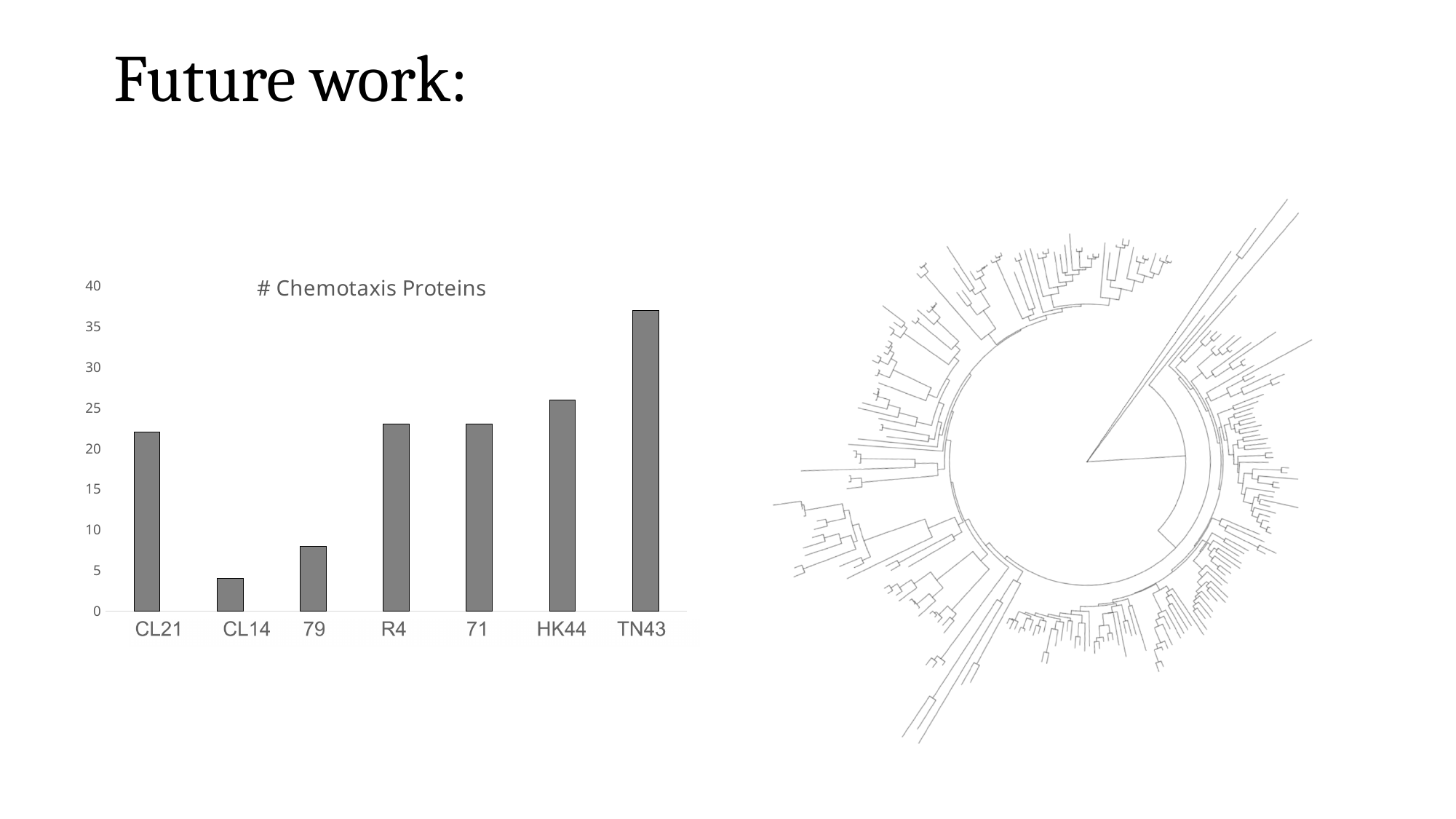
In the # Chemotaxis Proteins chart, is the value for TN43 greater or less than 35? greater In the # Chemotaxis Proteins chart, which category has the highest value? TN43 What kind of chart is shown on the left of the slide? bar chart What is the title of the bar chart? # Chemotaxis Proteins In the # Chemotaxis Proteins chart, which category has the lowest value? CL14 How many categories are shown on the x axis of the # Chemotaxis Proteins chart? 7 In the # Chemotaxis Proteins chart, is the value for 79 greater or less than 10? less In the # Chemotaxis Proteins chart, is the value for CL21 greater or less than 20? greater What is the highest value shown on the y axis of the # Chemotaxis Proteins chart? 40 In the # Chemotaxis Proteins chart, which is larger, the value for HK44 or the value for CL21? HK44 In the # Chemotaxis Proteins chart, which is larger, the value for 79 or the value for CL14? 79